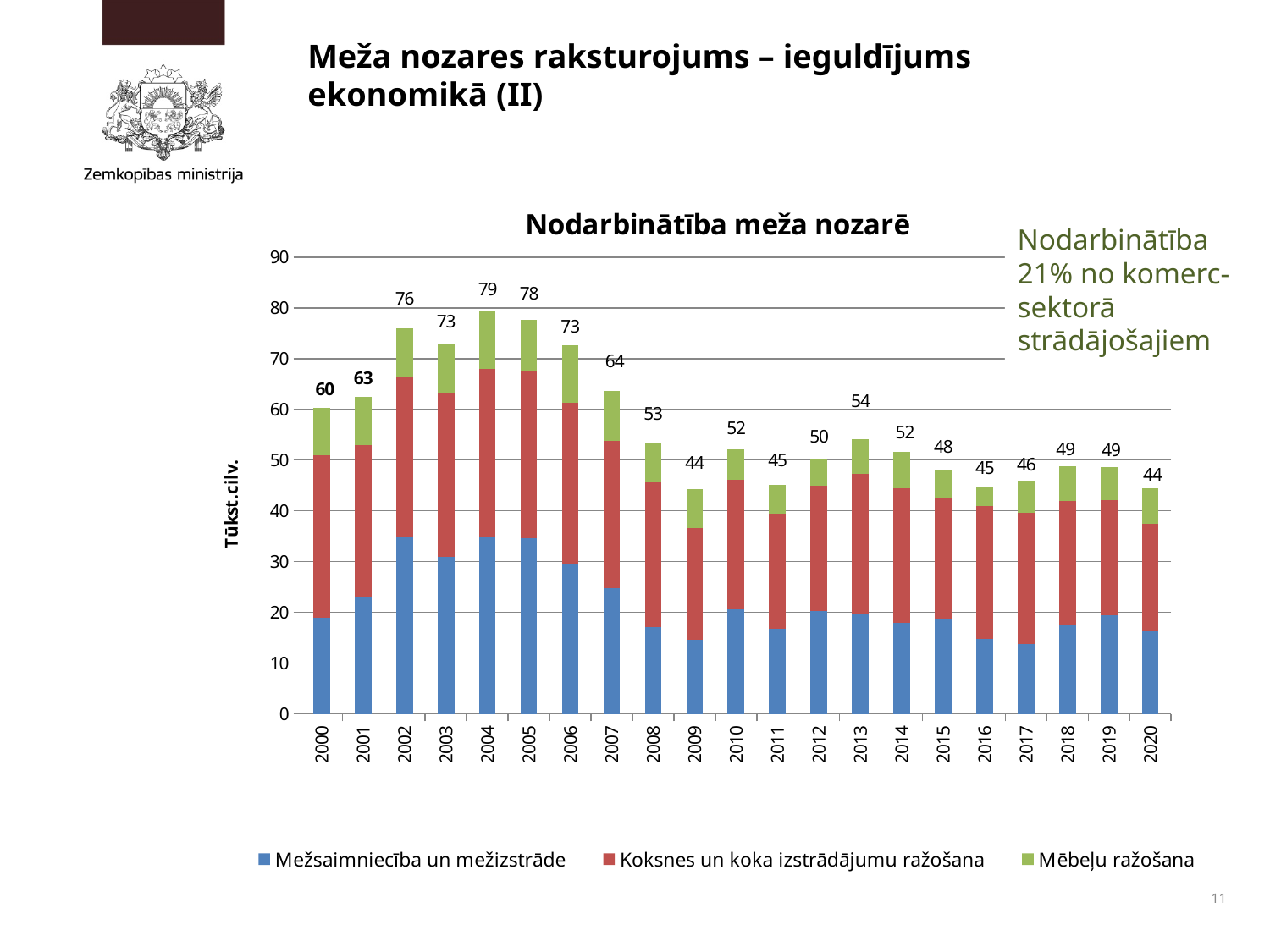
Which year has the highest total employment in the chart? 2004 What kind of chart is shown on the slide? Stacked bar chart What is the total employment value shown for 2004? 79 Which year has the larger total, 2007 or 2013? 2007 What is the title of the chart? Nodarbinātība meža nozarē Is the value for Mežsaimniecība un mežizstrāde in 2002 greater or less than 30? greater How many years are shown on the x axis of the chart? 21 Is the value for Mežsaimniecība un mežizstrāde in 2017 greater or less than 20? less What is the total value labelled above the bar for 2020? 44 How many series does the legend list? 3 Do the total values rise or fall from 2004 to 2009? Fall What is the difference between the total for 2004 and the total for 2020? 35